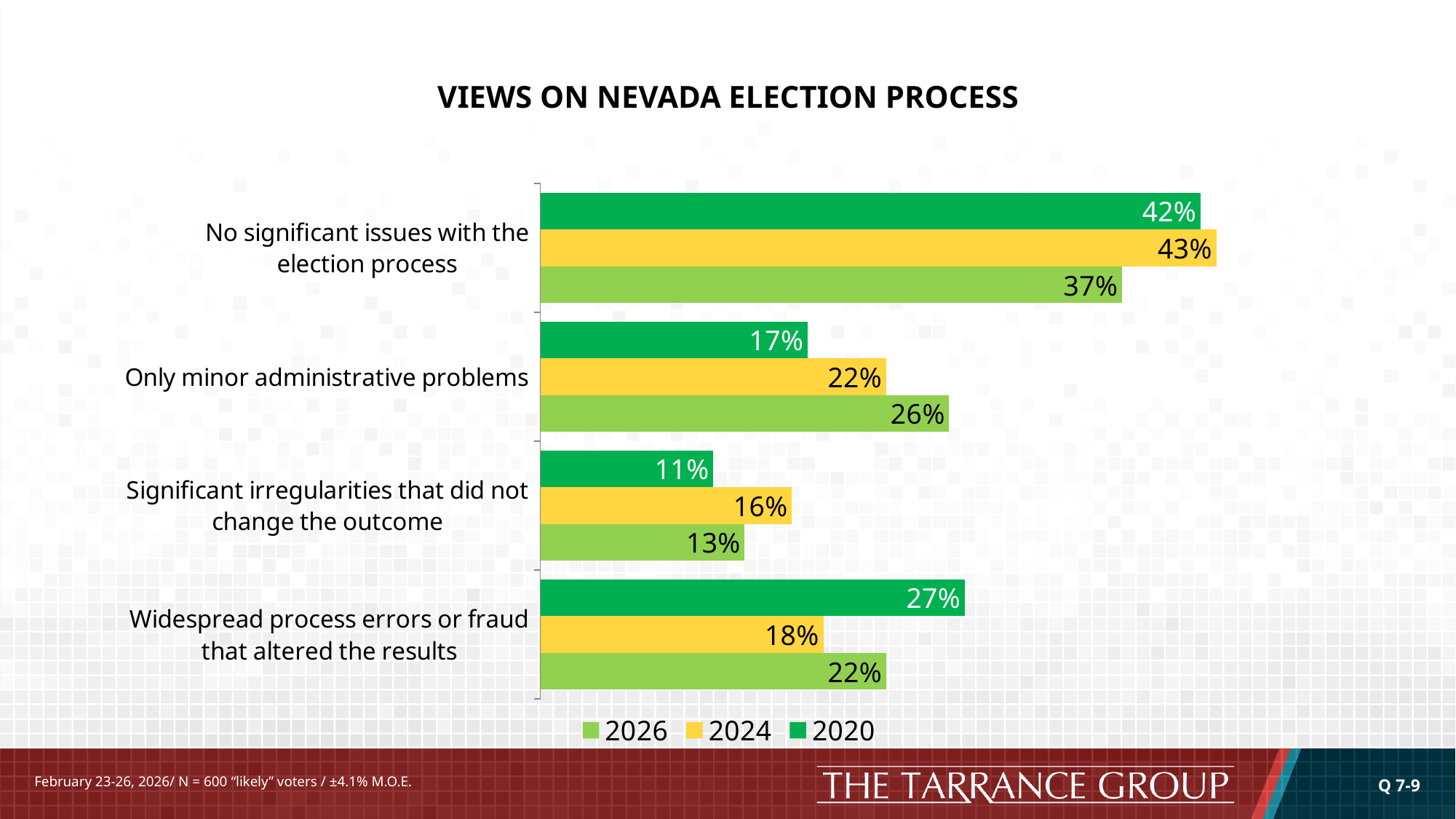
What is the 2024 value for "Only minor administrative problems"? 22% What is the 2020 value for "Widespread process errors or fraud that altered the results"? 27% For "Only minor administrative problems", which is larger, the 2020 value or the 2026 value? 2026 Which category has the highest 2024 value? No significant issues with the election process Which category has the lowest 2020 value? Significant irregularities that did not change the outcome How many series does the legend list? 3 What is the title of the chart? VIEWS ON NEVADA ELECTION PROCESS What kind of chart is shown on the slide? Bar chart How many categories are shown on the chart? 4 What is the difference between the 2020 and 2026 values for "Widespread process errors or fraud that altered the results"? 5% What is the 2026 value for "Significant irregularities that did not change the outcome"? 13% What is the 2026 value for "No significant issues with the election process"? 37%